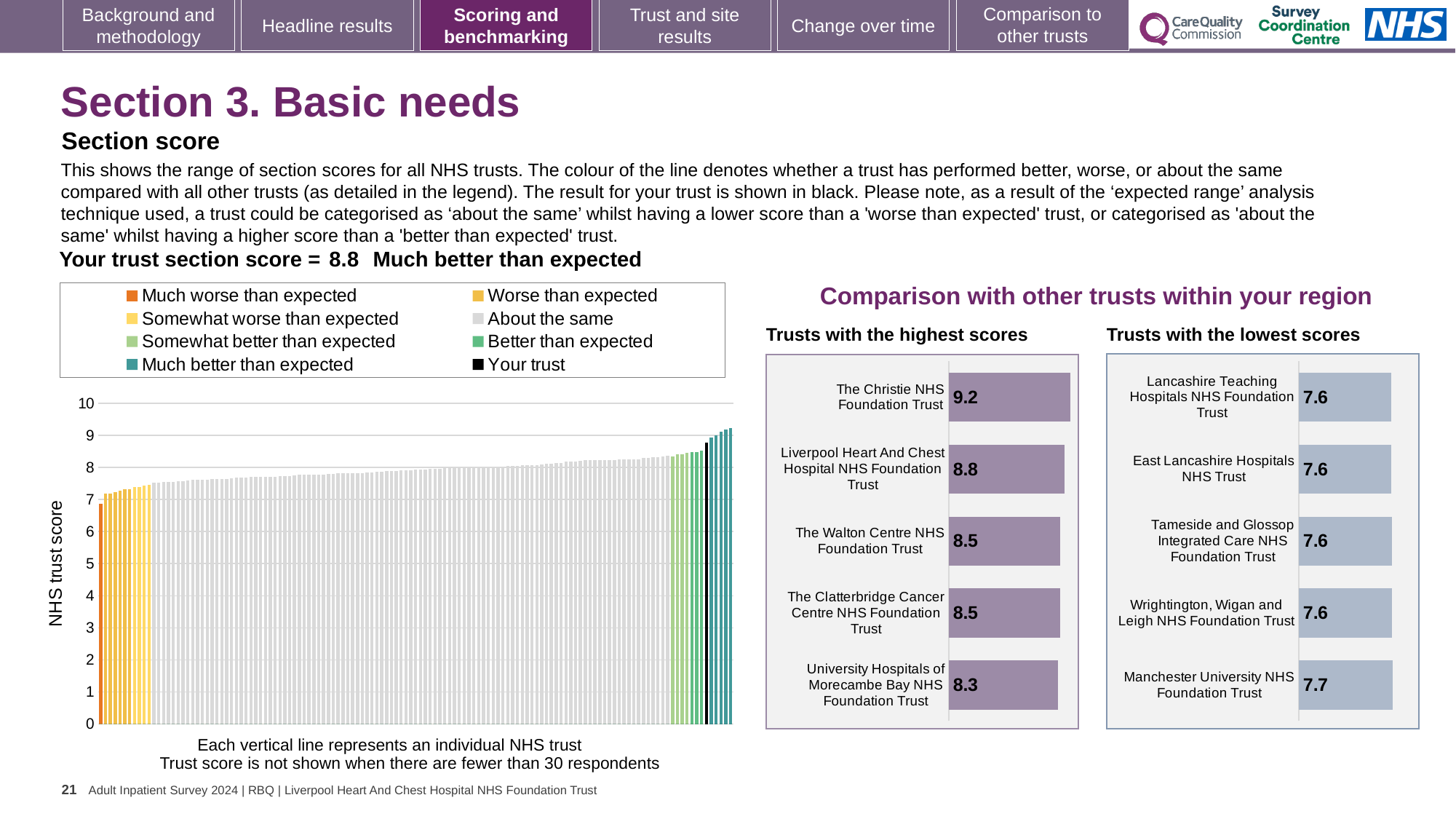
In the 'Trusts with the highest scores' chart, what is the score for University Hospitals of Morecambe Bay NHS Foundation Trust? 8.3 In the 'Trusts with the highest scores' chart, what is the score for The Christie NHS Foundation Trust? 9.2 In the 'Trusts with the highest scores' chart, what is the difference between the scores of The Christie NHS Foundation Trust and Liverpool Heart And Chest Hospital NHS Foundation Trust? 0.4 How many trusts are shown in the 'Trusts with the lowest scores' chart? 5 In the 'Trusts with the highest scores' chart, which trust has the highest score? The Christie NHS Foundation Trust How many entries does the legend of the main 'NHS trust score' chart list? 8 In the 'Trusts with the highest scores' chart, which has a higher score: The Walton Centre NHS Foundation Trust or University Hospitals of Morecambe Bay NHS Foundation Trust? The Walton Centre NHS Foundation Trust In the 'Trusts with the lowest scores' chart, what is the difference between the scores of Manchester University NHS Foundation Trust and East Lancashire Hospitals NHS Trust? 0.1 In the main 'NHS trust score' chart, is the value for your trust (the black line) greater or less than 8? greater In the 'Trusts with the lowest scores' chart, what is the score for Manchester University NHS Foundation Trust? 7.7 In the 'Trusts with the highest scores' chart, which trust has the lowest score? University Hospitals of Morecambe Bay NHS Foundation Trust What type of chart is the 'Trusts with the highest scores' chart? Bar chart